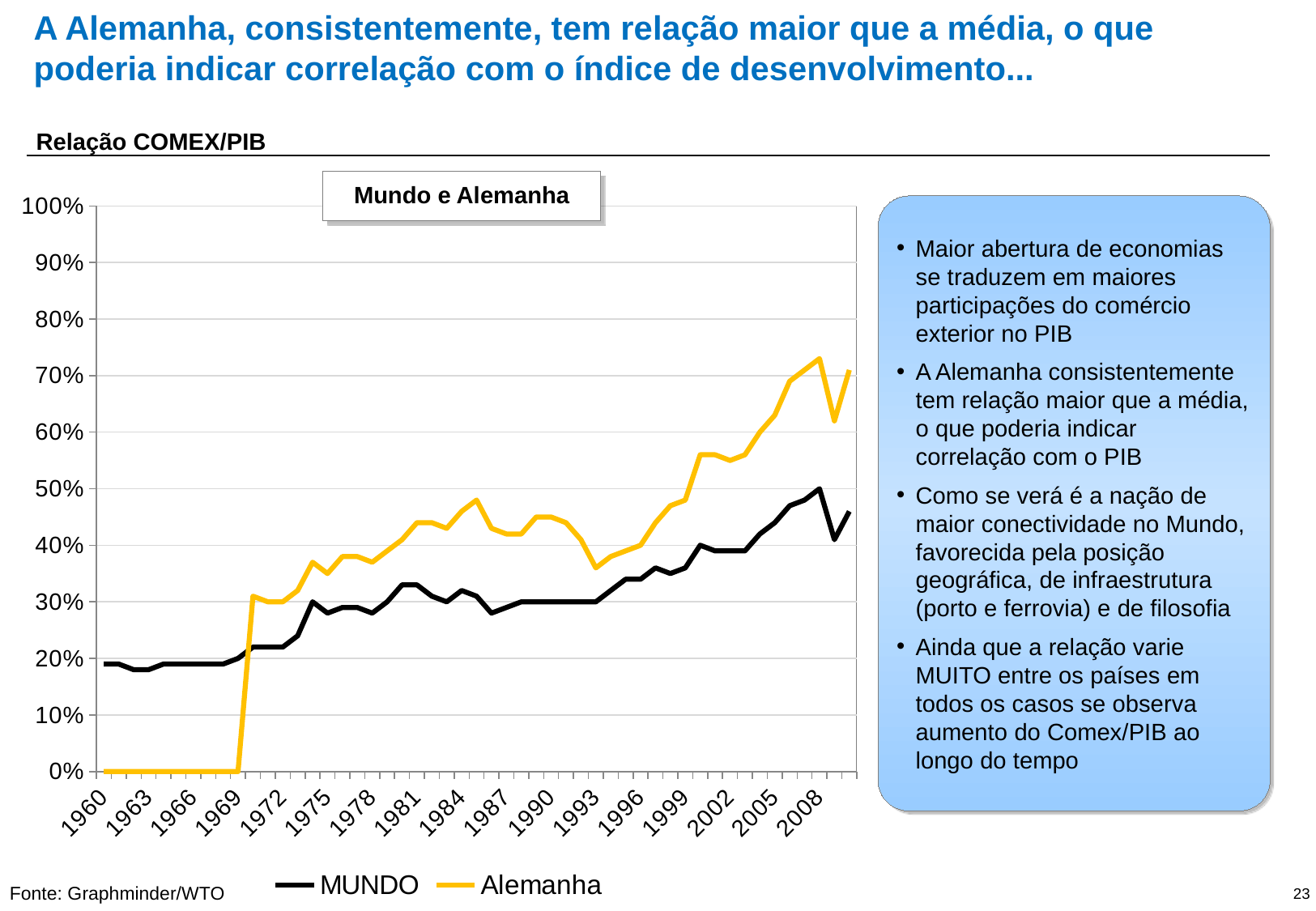
What is the value for Alemanha in 1960? 0% What kind of chart is shown on the slide? line chart What is the title shown above the chart? Mundo e Alemanha How many series does the legend list? 2 Is the value for Alemanha in 2008 greater or less than 70%? greater Which series has the higher value in 2005, MUNDO or Alemanha? Alemanha Is the value for MUNDO in 1981 greater or less than 30%? greater Is the value for Alemanha in 1999 greater or less than 50%? less Which colour is used for the Alemanha line? yellow Does the MUNDO line generally rise or fall from 1960 to the end of the series? rise Which series has the higher value in 1960, MUNDO or Alemanha? MUNDO